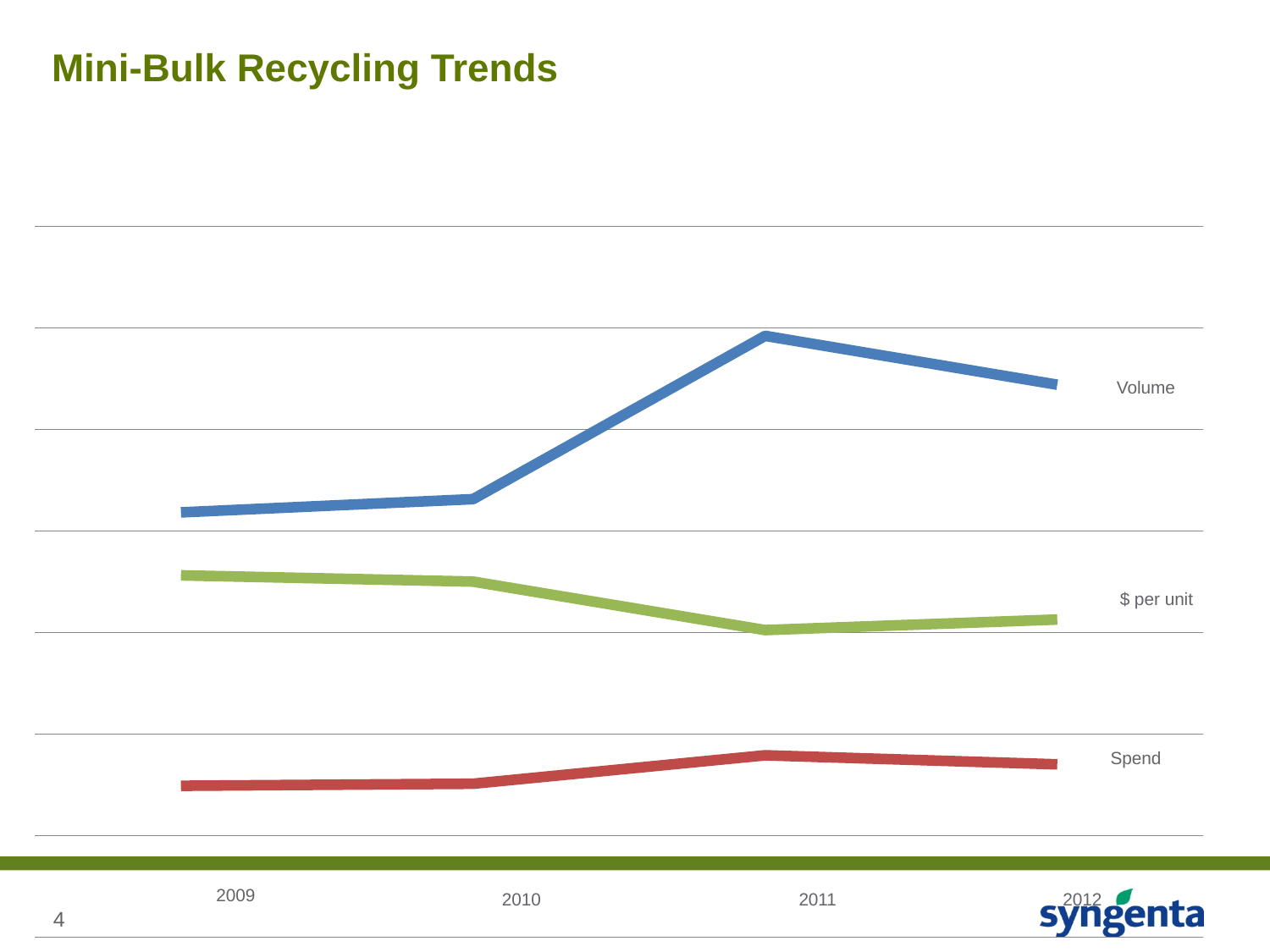
Which year has the larger Volume value, 2011 or 2012? 2011 Does the $ per unit line rise or fall from 2009 to 2011? Fall Does the Volume line rise or fall from 2009 to 2011? Rise In which year does the $ per unit line reach its lowest point? 2011 What is the title of the chart on the slide? Mini-Bulk Recycling Trends In which year does the Volume line reach its highest point? 2011 How many series are plotted on the chart? 3 Which year has the larger Spend value, 2009 or 2011? 2011 Which year has the larger $ per unit value, 2010 or 2011? 2010 Does the Volume line rise or fall from 2011 to 2012? Fall What kind of chart is shown on the slide? Line chart How many years are shown along the x axis of the chart? 4